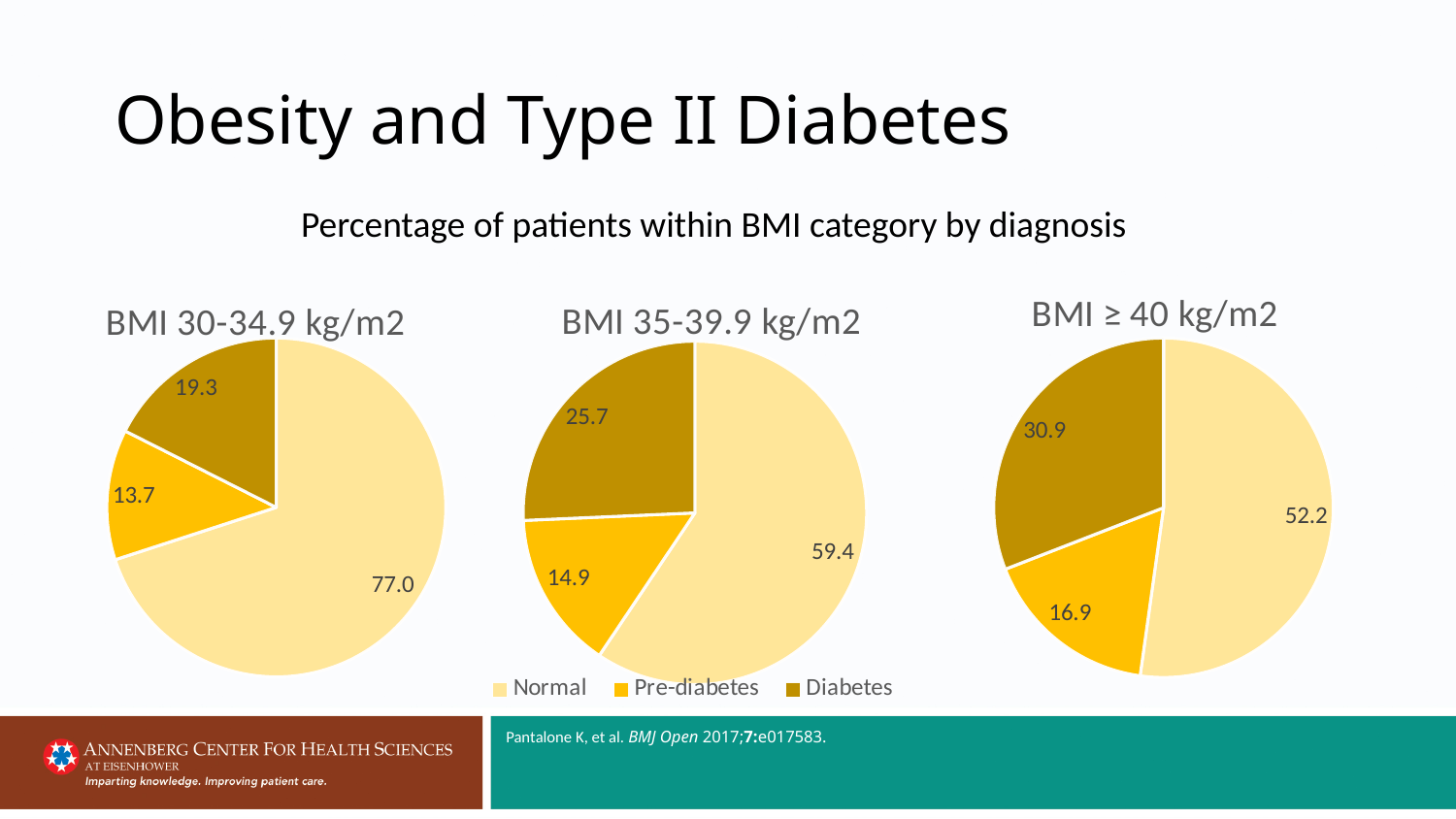
What is the subtitle above the three charts? Percentage of patients within BMI category by diagnosis Across the three charts from BMI 30-34.9 to BMI ≥ 40, does the Normal value rise or fall? Fall What kind of chart is the BMI ≥ 40 kg/m2 chart? Pie chart Is the Diabetes value larger in the BMI 30-34.9 kg/m2 chart or the BMI ≥ 40 kg/m2 chart? BMI ≥ 40 kg/m2 In the BMI 30-34.9 kg/m2 chart, what is the value for Normal? 77.0 In the BMI 35-39.9 kg/m2 chart, what is the value for Diabetes? 25.7 In the BMI 35-39.9 kg/m2 chart, what is the difference between the Normal and Diabetes values? 33.7 How many slices does the BMI 35-39.9 kg/m2 chart have? 3 In the BMI ≥ 40 kg/m2 chart, which category has the largest slice? Normal How many entries does the legend list? 3 In the BMI ≥ 40 kg/m2 chart, what is the value for Pre-diabetes? 16.9 In the BMI 30-34.9 kg/m2 chart, which category has the smallest slice? Pre-diabetes